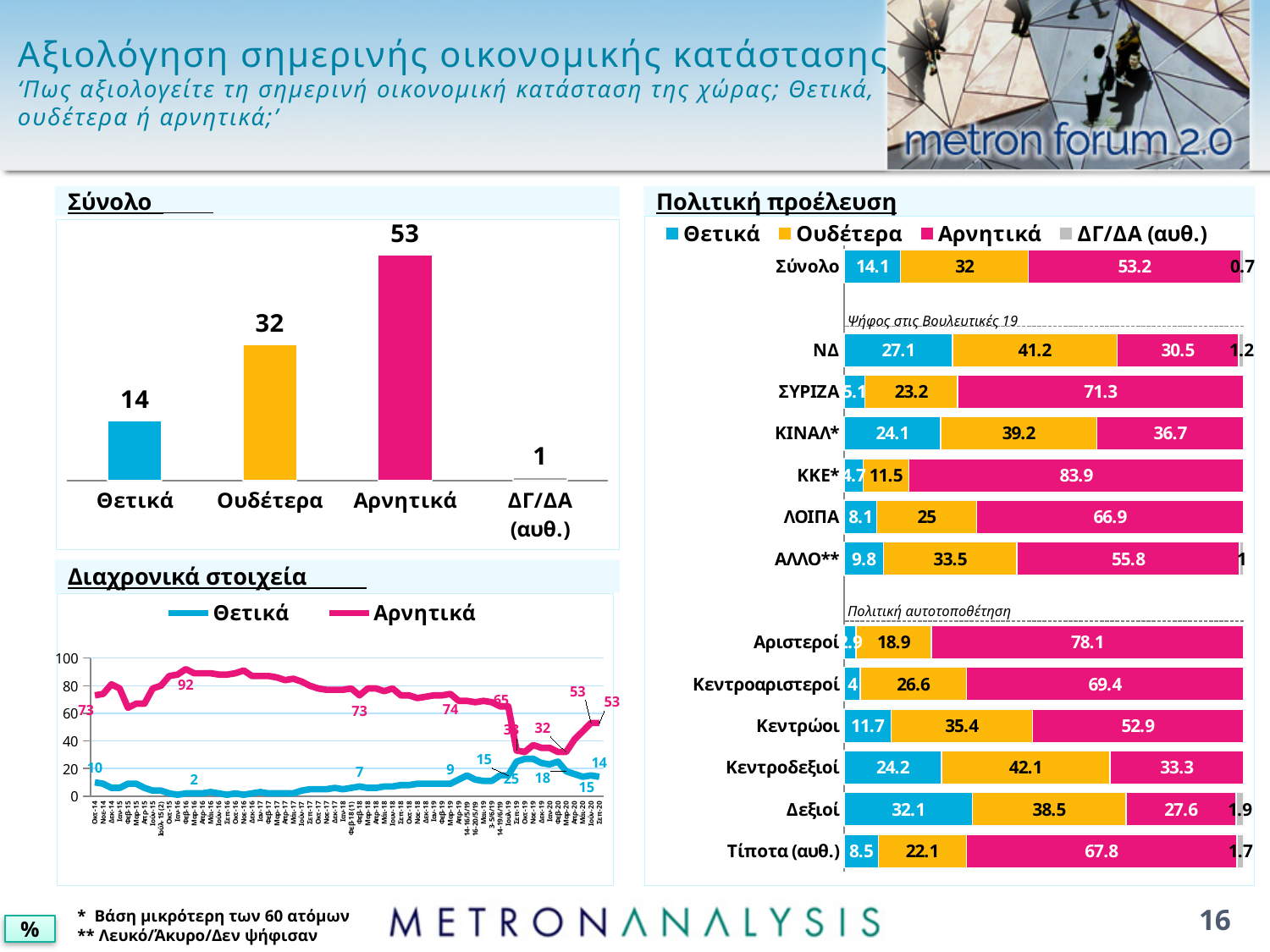
What kind of chart is the Σύνολο chart? bar chart How many series does the legend of the Διαχρονικά στοιχεία chart list? 2 In the Πολιτική προέλευση chart, which category has the highest Αρνητικά value? ΚΚΕ* What kind of chart is the Διαχρονικά στοιχεία chart? line chart In the Πολιτική προέλευση chart, what is the Θετικά value for Δεξιοί? 32.1 In the Πολιτική προέλευση chart, what is the Αρνητικά value for ΚΚΕ*? 83.9 How many categories are shown in the Σύνολο chart? 4 In the Σύνολο chart, which category has the highest value? Αρνητικά How many series does the legend of the Πολιτική προέλευση chart list? 4 In the Πολιτική προέλευση chart, which has the larger Θετικά value, ΝΔ or ΚΙΝΑΛ*? ΝΔ In the Σύνολο chart, what is the difference between the values for Αρνητικά and Ουδέτερα? 21 In the Σύνολο chart, what is the value for Αρνητικά? 53